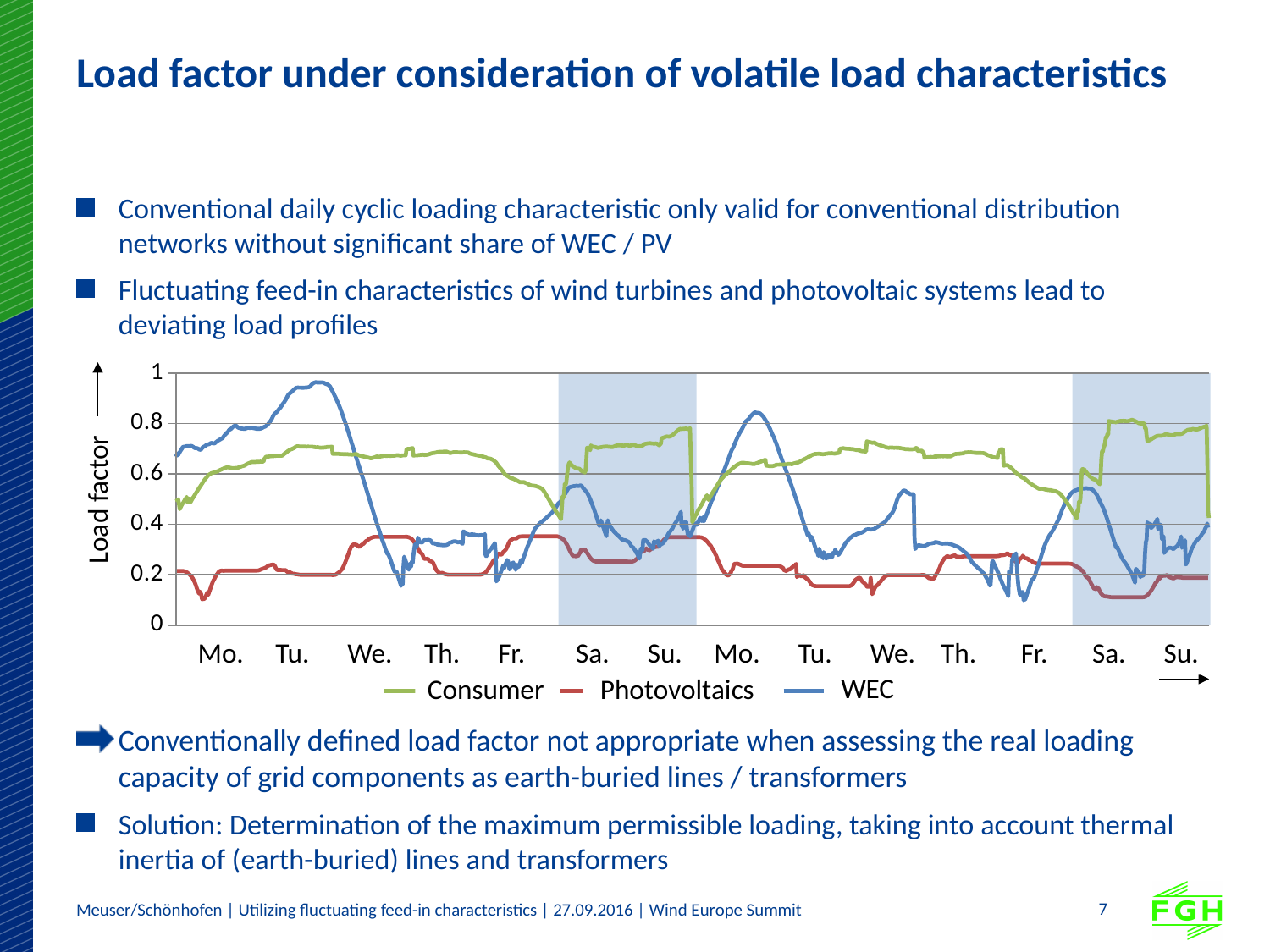
Is the highest value reached by the Photovoltaics series greater or less than 0.4? less Which series stays at the lowest load factor values overall in the chart? Photovoltaics How many day labels are shown along the x axis of the chart? 14 What kind of chart is shown on the slide? line chart What are the three series named in the chart legend? Consumer, Photovoltaics, WEC Is the Photovoltaics value on the second Saturday greater or less than 0.2? less Is the peak value of the WEC series on the first Tuesday greater or less than 0.8? greater What is the label of the vertical axis of the chart? Load factor On the first Saturday, which series has the larger load factor, Consumer or Photovoltaics? Consumer How many series does the chart legend list? 3 Which series reaches the highest load factor anywhere in the chart? WEC At the peak on the first Tuesday, which series is larger, WEC or Consumer? WEC